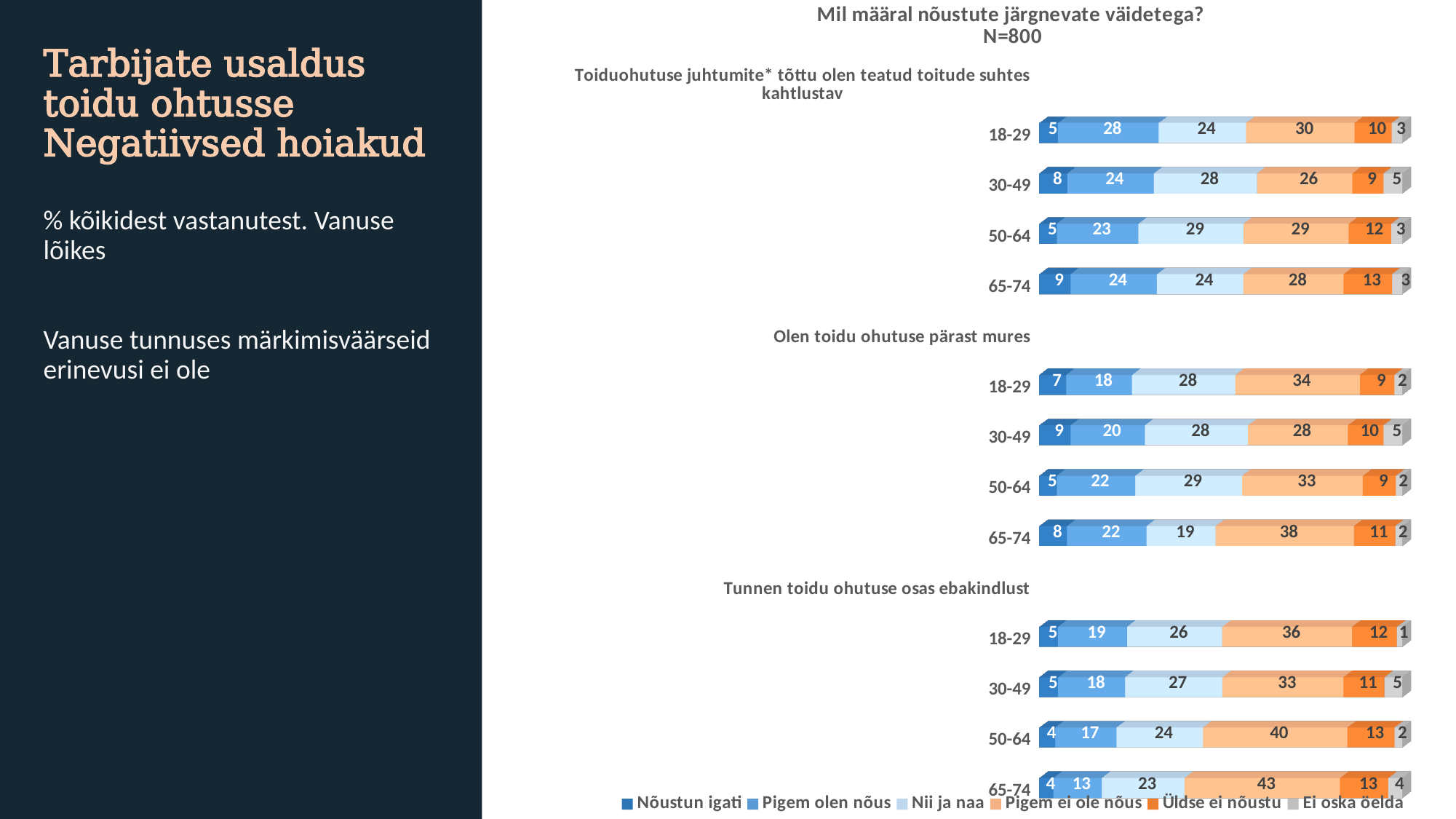
How many age groups are shown for each statement in the chart? 4 In the 'Olen toidu ohutuse pärast mures' section, what is the 'Ei oska öelda' value for the 30-49 age group? 5 What kind of chart is shown on the slide? Stacked bar chart What is the total of the stacked bar for the 18-29 age group in the 'Toiduohutuse juhtumite* tõttu olen teatud toitude suhtes kahtlustav' section? 100 How many series does the chart legend list? 6 In the 'Toiduohutuse juhtumite* tõttu olen teatud toitude suhtes kahtlustav' section, what is the 'Pigem ei ole nõus' value for the 18-29 age group? 30 In the 'Olen toidu ohutuse pärast mures' section, which age group has the lowest 'Nii ja naa' value? 65-74 In the 'Olen toidu ohutuse pärast mures' section, which age group has the larger 'Pigem olen nõus' value: 18-29 or 50-64? 50-64 In the 'Tunnen toidu ohutuse osas ebakindlust' section, which age group has the highest 'Pigem ei ole nõus' value? 65-74 In the 'Tunnen toidu ohutuse osas ebakindlust' section, how much larger is the 'Pigem ei ole nõus' value for 65-74 than for 18-29? 7 In the 'Olen toidu ohutuse pärast mures' section, what is the 'Pigem ei ole nõus' value for the 65-74 age group? 38 In the 'Tunnen toidu ohutuse osas ebakindlust' section, what is the 'Pigem ei ole nõus' value for the 50-64 age group? 40